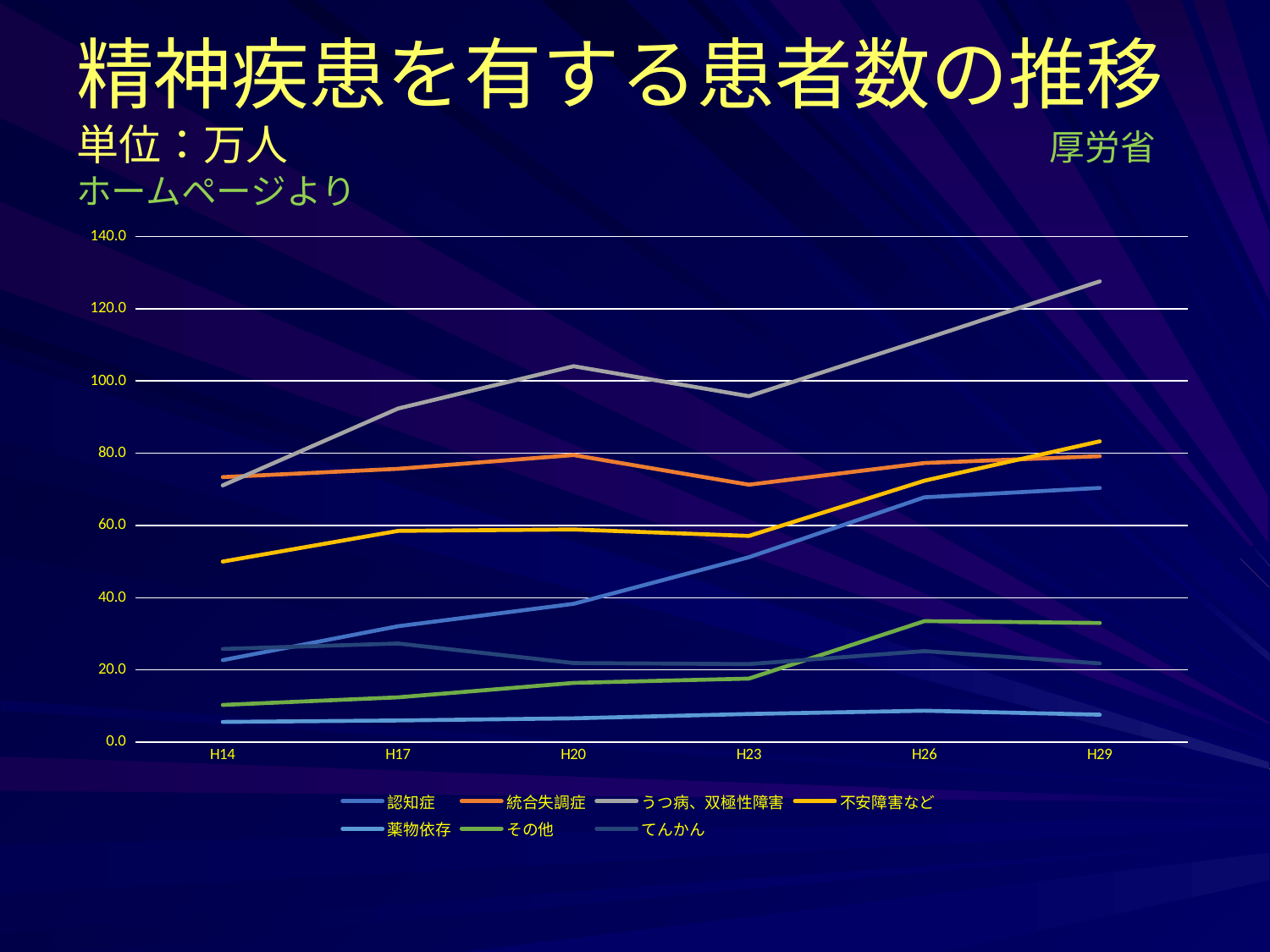
Is the value for 不安障害など at H14 greater or less than 40? greater Does the value for 認知症 rise or fall from H14 to H29? rise Which series has the highest value at H29? うつ病、双極性障害 In which year is the value for うつ病、双極性障害 highest? H29 Is the value for うつ病、双極性障害 at H29 greater or less than 120? greater What unit is stated for the values on the slide? 万人 How many series does the legend list? 7 At H29, which is larger: 認知症 or その他? 認知症 How many time points are shown on the x axis? 6 What kind of chart is shown on the slide? line chart Which series has the lowest value at H29? 薬物依存 Is the value for その他 at H26 greater or less than 40? less